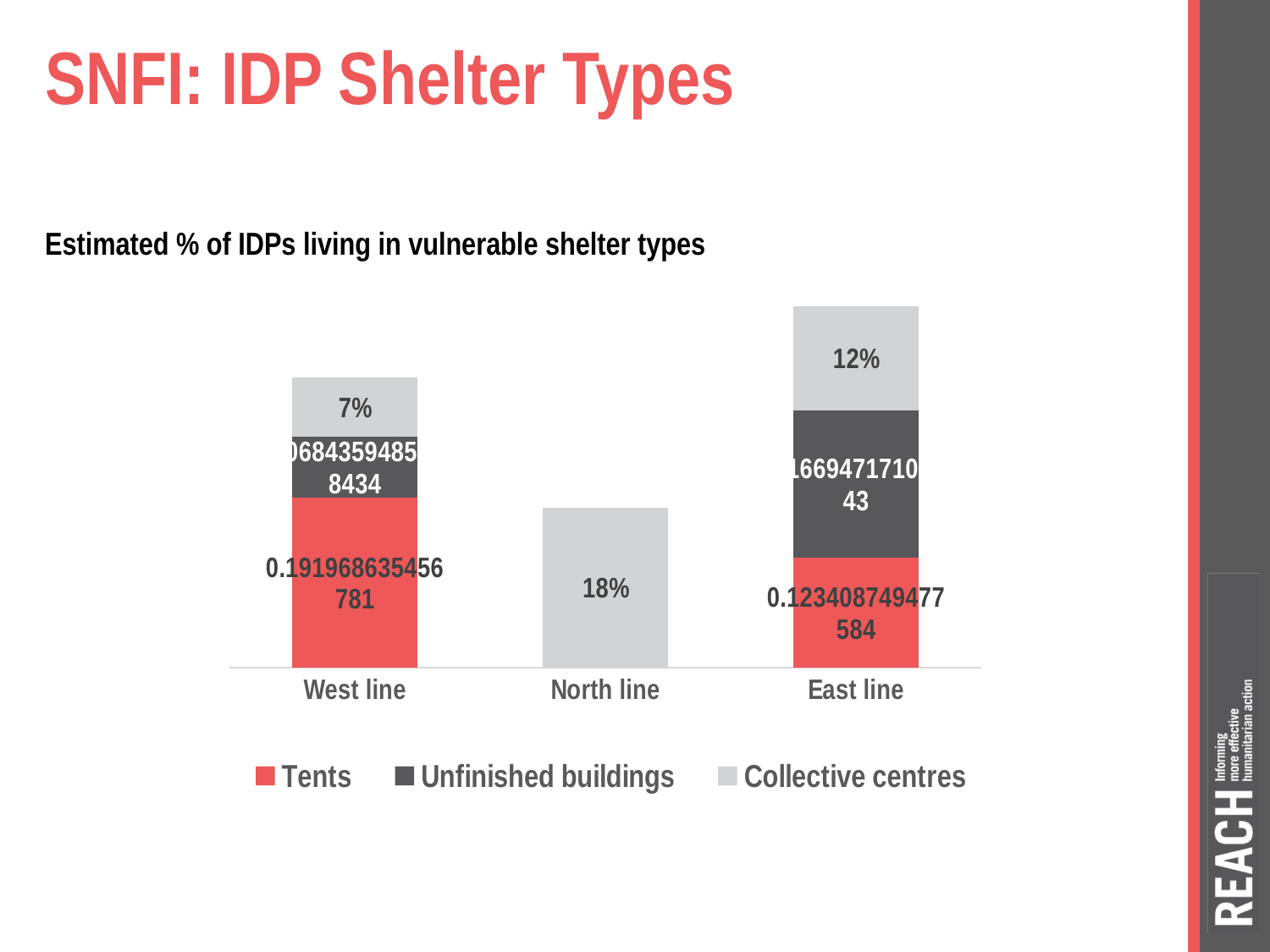
Which has a larger Collective centres value, East line or West line? East line Which category's bar consists of only a Collective centres segment? North line How many series does the legend list? 3 What is the value for Collective centres in the East line bar? 12% How many categories are shown on the x axis? 3 What is the difference between the Collective centres values for North line and West line? 11% What kind of chart is shown on the slide? Stacked bar chart Which category has the highest Collective centres value? North line What is the value for Collective centres in the North line bar? 18% Which category has the lowest Collective centres value? West line What is the value for Collective centres in the West line bar? 7% What is the difference between the Collective centres values for East line and West line? 5%